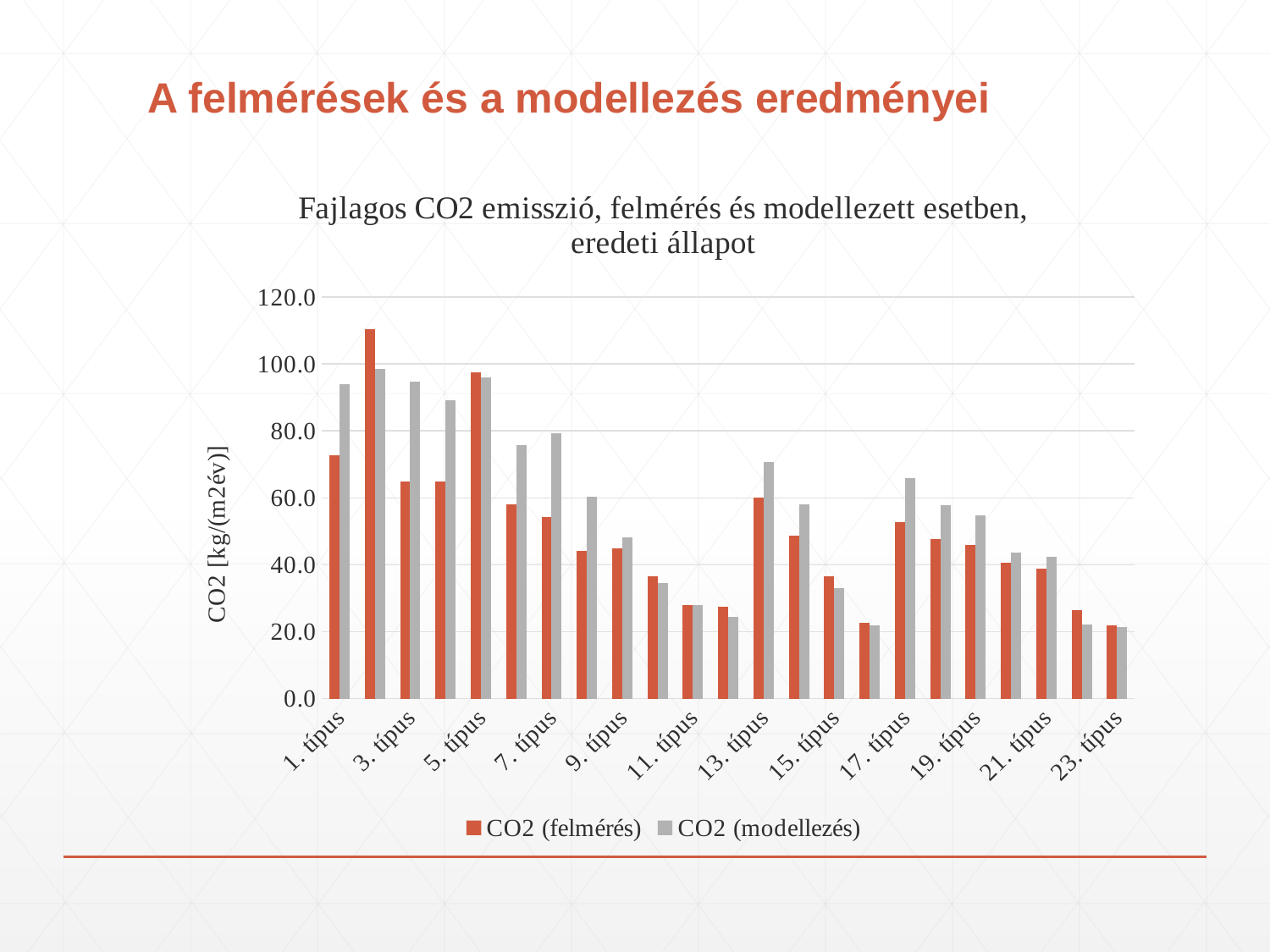
Is the CO2 (felmérés) value for 1. típus greater or less than 60? greater Is the CO2 (modellezés) value for 3. típus greater or less than 80? greater For 1. típus, which is larger: CO2 (felmérés) or CO2 (modellezés)? CO2 (modellezés) What kind of chart is shown on the slide? bar chart What is the label of the vertical axis? CO2 [kg/(m2év)] Do the CO2 (felmérés) values generally rise or fall from 1. típus to 23. típus? fall Is the CO2 (modellezés) value for 13. típus greater or less than 60? greater How many series does the legend list? 2 What are the two series named in the legend? CO2 (felmérés) and CO2 (modellezés) For 7. típus, which is larger: CO2 (felmérés) or CO2 (modellezés)? CO2 (modellezés)